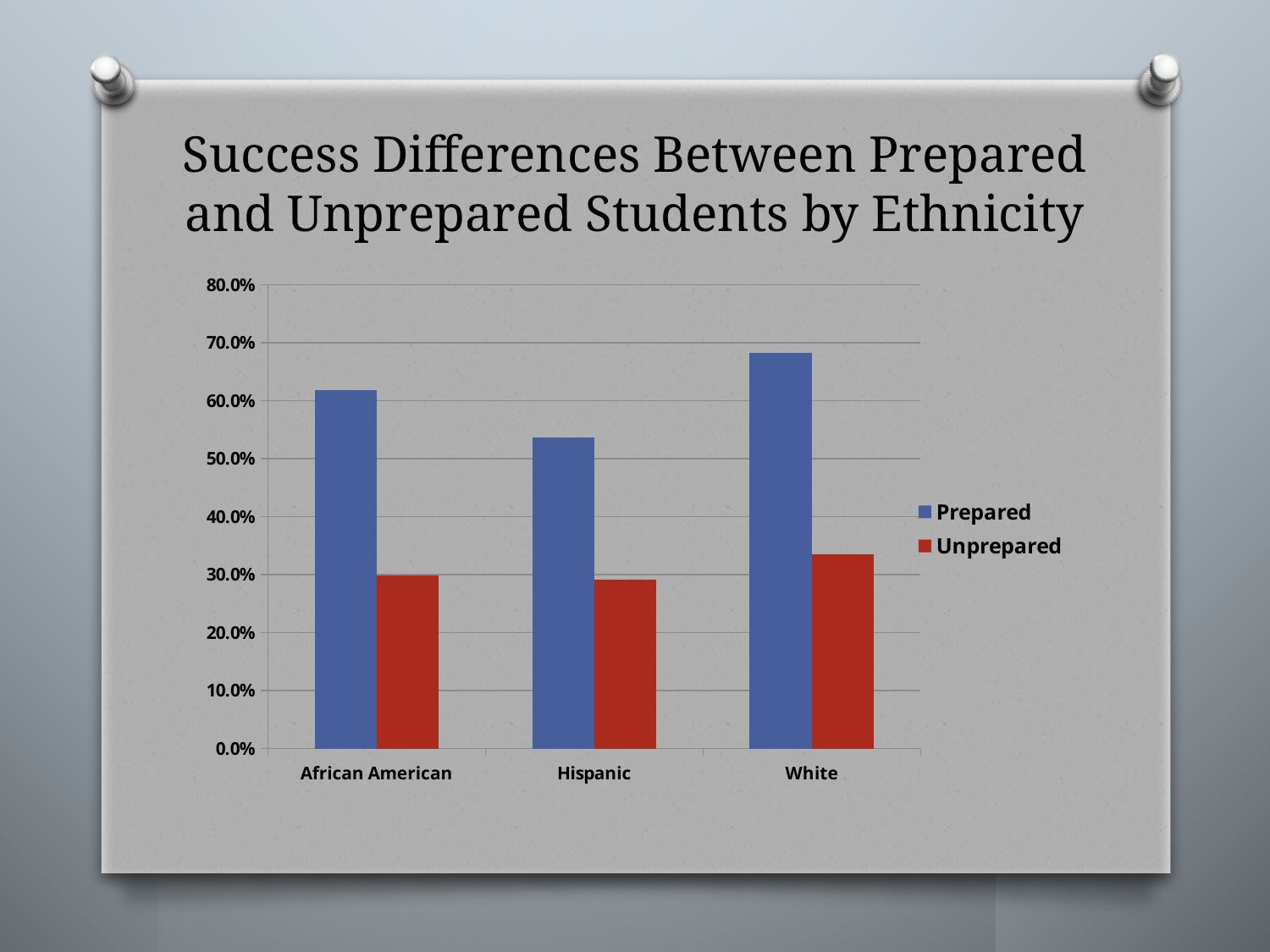
Is the Unprepared value for White greater or less than 30.0%? greater Which ethnicity has the highest value for the Unprepared series? White Which ethnicity has the lowest value for the Prepared series? Hispanic How many series does the legend list? 2 What colour are the bars for the Unprepared series? red Is the Prepared value for White greater or less than 70.0%? less Is the Prepared value for Hispanic greater or less than 60.0%? less For Hispanic students, which is larger: the Prepared value or the Unprepared value? Prepared How many ethnicity categories are shown on the x axis? 3 Which ethnicity has the highest value for the Prepared series? White What kind of chart is shown on the slide? bar chart